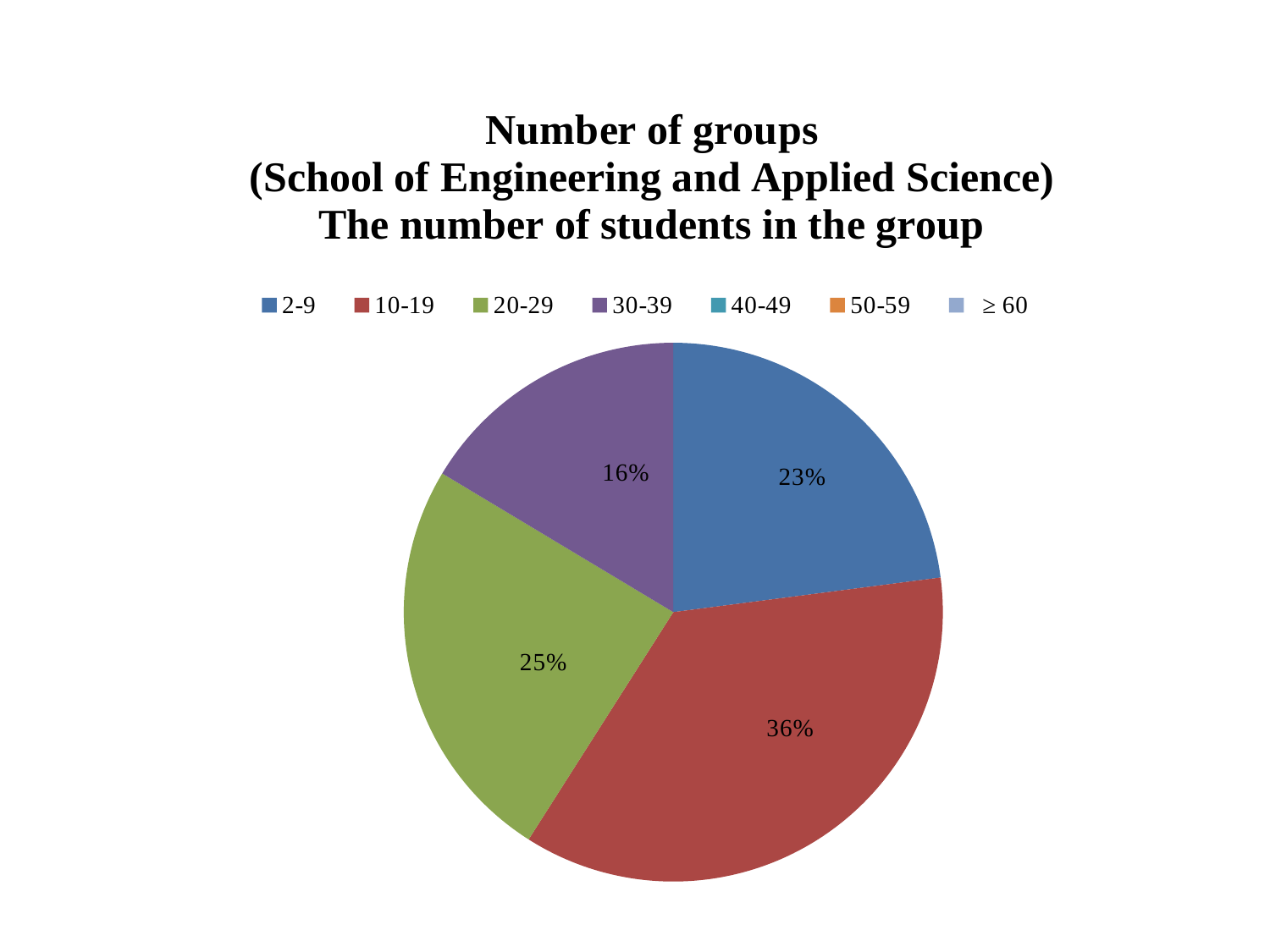
What percentage is shown for the 2-9 category? 23% Which school is named in the chart title? School of Engineering and Applied Science What percentage is shown for the 30-39 category? 16% Which slice is larger, 2-9 or 20-29? 20-29 Which category has the largest slice of the pie? 10-19 Of the slices with printed labels, which category has the smallest share? 30-39 What is the difference in percentage points between the 10-19 slice and the 2-9 slice? 13 What is the difference in percentage points between the 20-29 slice and the 30-39 slice? 9 What type of chart is shown on the slide? Pie chart What share of the pie does the 10-19 category represent? 36% How many categories does the legend list? 7 What percentage is shown for the 20-29 category? 25%